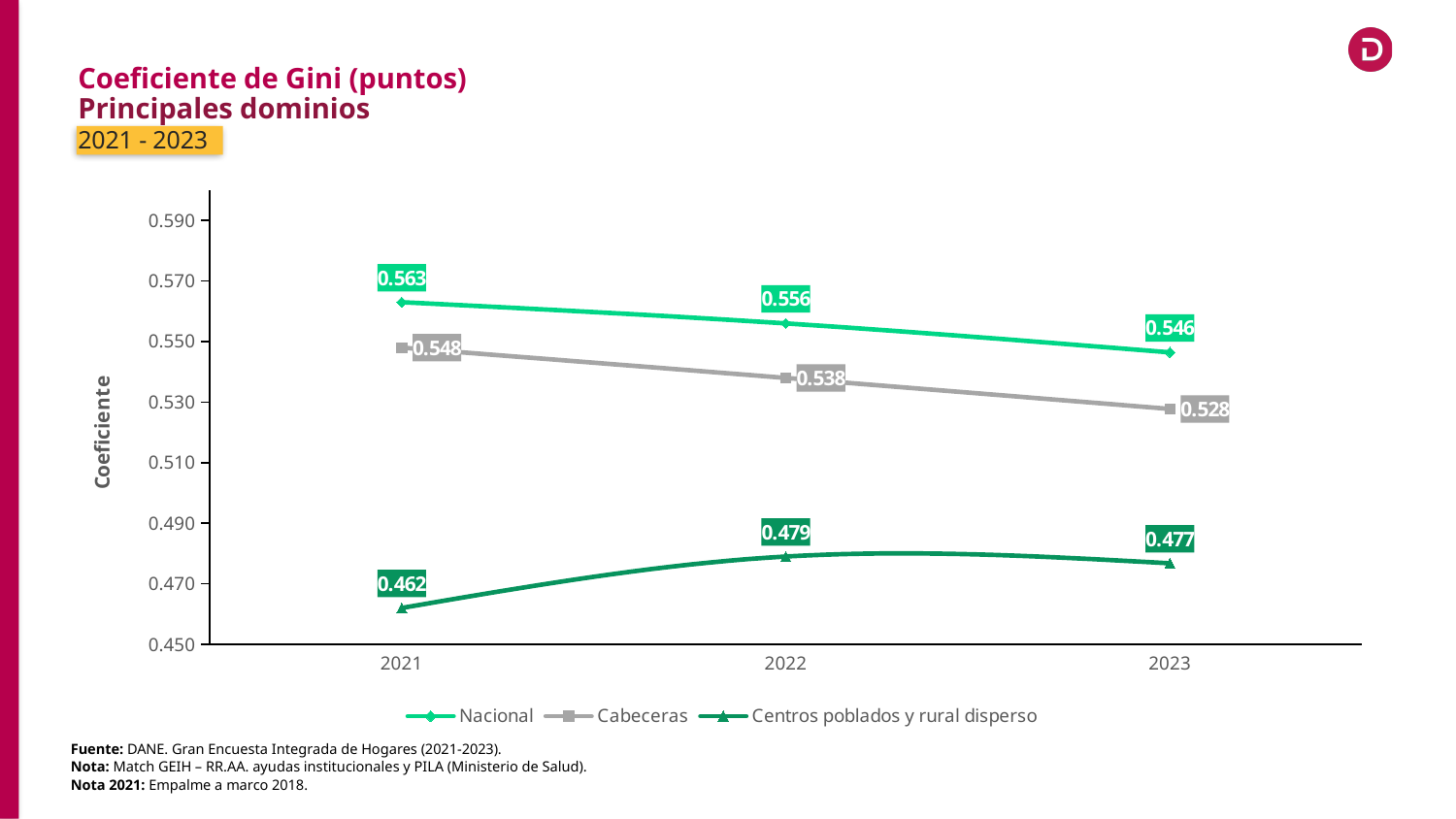
What kind of chart is shown on the slide? Line chart What is the Gini coefficient for Centros poblados y rural disperso in 2022? 0.479 Which series has the larger Gini coefficient in 2023, Cabeceras or Centros poblados y rural disperso? Cabeceras How many series does the legend list? 3 What is the Gini coefficient for Nacional in 2021? 0.563 Does the Cabeceras Gini coefficient rise or fall from 2021 to 2023? Fall In which year is the Nacional Gini coefficient highest? 2021 What is the difference between the Nacional and Cabeceras Gini coefficients in 2022? 0.018 In which year is the Centros poblados y rural disperso Gini coefficient lowest? 2021 What is the label of the y axis? Coeficiente What is the Gini coefficient for Cabeceras in 2023? 0.528 How many years are shown on the x axis? 3